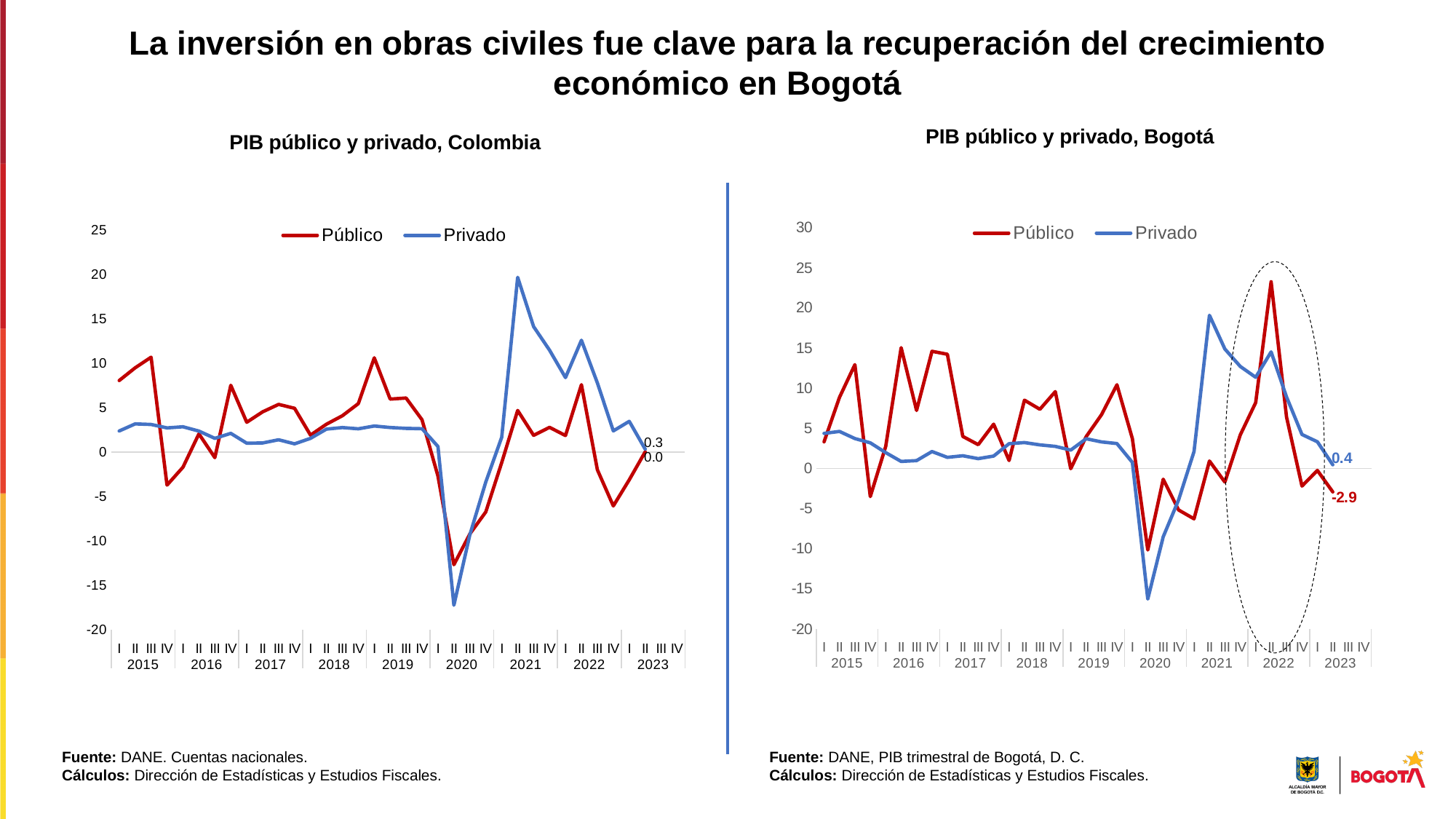
How many series does the legend of 'PIB público y privado, Bogotá' list? 2 In 'PIB público y privado, Bogotá', which series has the larger final labelled value, Público or Privado? Privado In 'PIB público y privado, Bogotá', what is the last labelled value of the Público series? -2.9 In 'PIB público y privado, Bogotá', which series reaches the higher peak value, Público or Privado? Público In 'PIB público y privado, Bogotá', is the peak of the Público series in 2022 greater or less than 20? greater In 'PIB público y privado, Bogotá', what is the difference between the last labelled Privado value and the last labelled Público value? 3.3 In 'PIB público y privado, Colombia', what is the last labelled value of the Público series? 0.0 How many years are labelled on the x axis of 'PIB público y privado, Colombia'? 9 In 'PIB público y privado, Colombia', is the lowest value of the Público series in 2020 greater or less than -10? less In 'PIB público y privado, Colombia', what is the last labelled value of the Privado series? 0.3 In 'PIB público y privado, Bogotá', what is the last labelled value of the Privado series? 0.4 What kind of chart is 'PIB público y privado, Colombia'? line chart